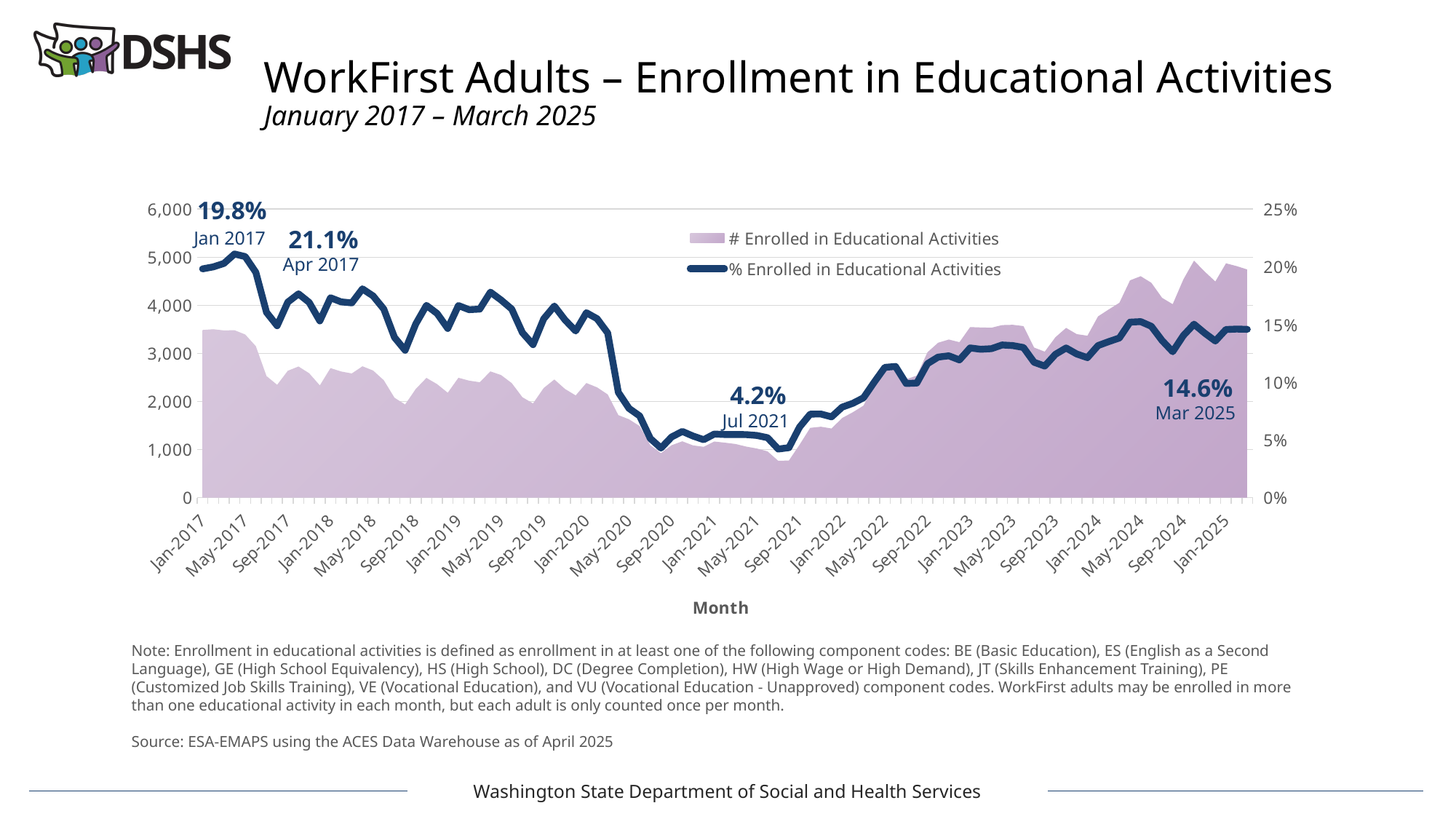
What was the % Enrolled in Educational Activities in Mar 2025? 14.6% What was the % Enrolled in Educational Activities in Jan 2017? 19.8% Which labeled month has the highest % Enrolled in Educational Activities? Apr 2017 Is the # Enrolled in Educational Activities in Jul 2021 greater or less than 1,000? less What was the % Enrolled in Educational Activities in Jul 2021? 4.2% Does the % Enrolled in Educational Activities rise or fall between Jul 2021 and Mar 2025? rise Is the # Enrolled in Educational Activities in Jan 2017 greater or less than 3,000? greater What was the % Enrolled in Educational Activities in Apr 2017? 21.1% How many series does the legend list? 2 Which labeled month has the lowest % Enrolled in Educational Activities? Jul 2021 What is the difference in percentage points between the % enrolled in Apr 2017 and Jul 2021? 16.9 percentage points Which is larger, the % enrolled in Jan 2017 or in Mar 2025? Jan 2017